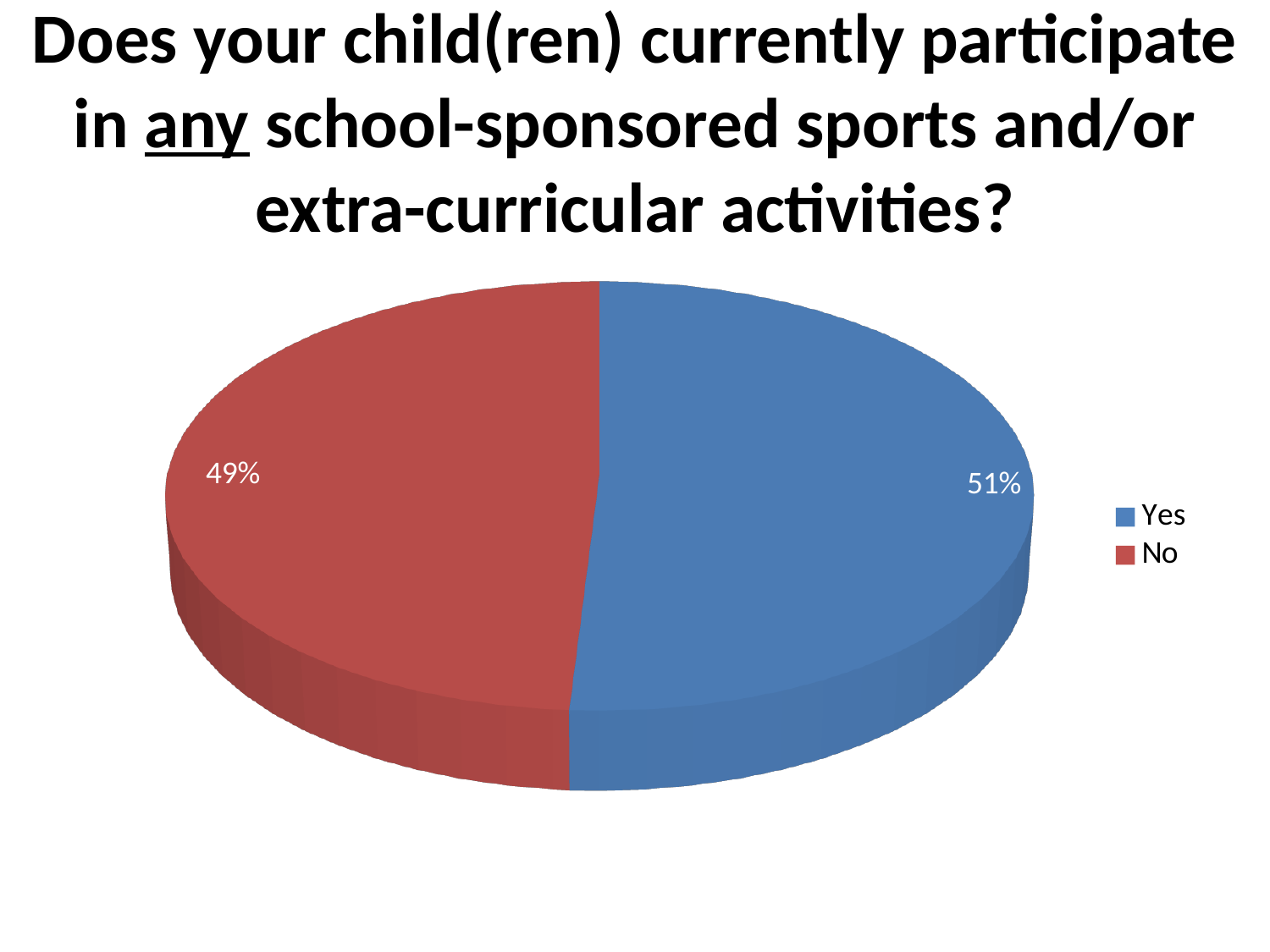
How many slices does the pie chart have? 2 What percentage of respondents answered No? 49% Which response has the larger share of the pie? Yes What colour is the Yes slice? blue Is the share for Yes larger or smaller than the share for No? larger How many entries does the legend list? 2 What share of the pie does the No slice represent? 49% What percentage of respondents answered Yes? 51% What type of chart is shown on the slide? pie chart What is the difference in percentage points between the Yes and No slices? 2 What colour is the No slice? red Which response has the smaller share of the pie? No